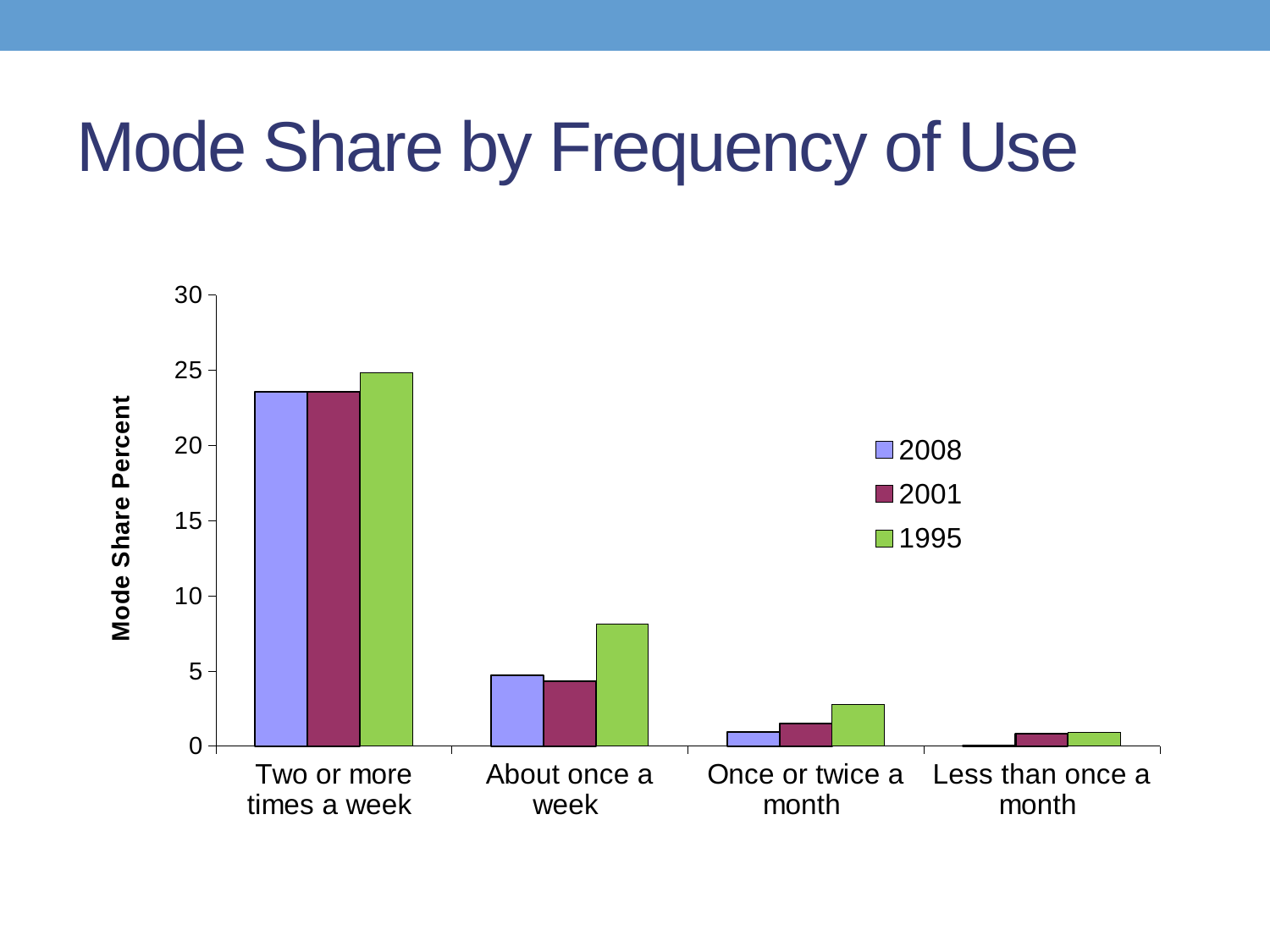
What is the title of the y axis? Mode Share Percent How many series does the legend list? 3 For the 2008 series, which category has the lowest mode share? Less than once a month What kind of chart is shown on the slide? bar chart How many frequency-of-use categories are shown on the x axis? 4 Is the 2001 value for Once or twice a month greater or less than 5? less Is the 1995 value for Two or more times a week greater or less than 20? greater For About once a week, which is larger: the 1995 value or the 2008 value? 1995 For Two or more times a week, which is larger: the 1995 value or the 2001 value? 1995 Is the 1995 value for About once a week greater or less than 5? greater Do the 1995 values rise or fall moving from left to right across the categories? fall For the 1995 series, which category has the highest mode share? Two or more times a week